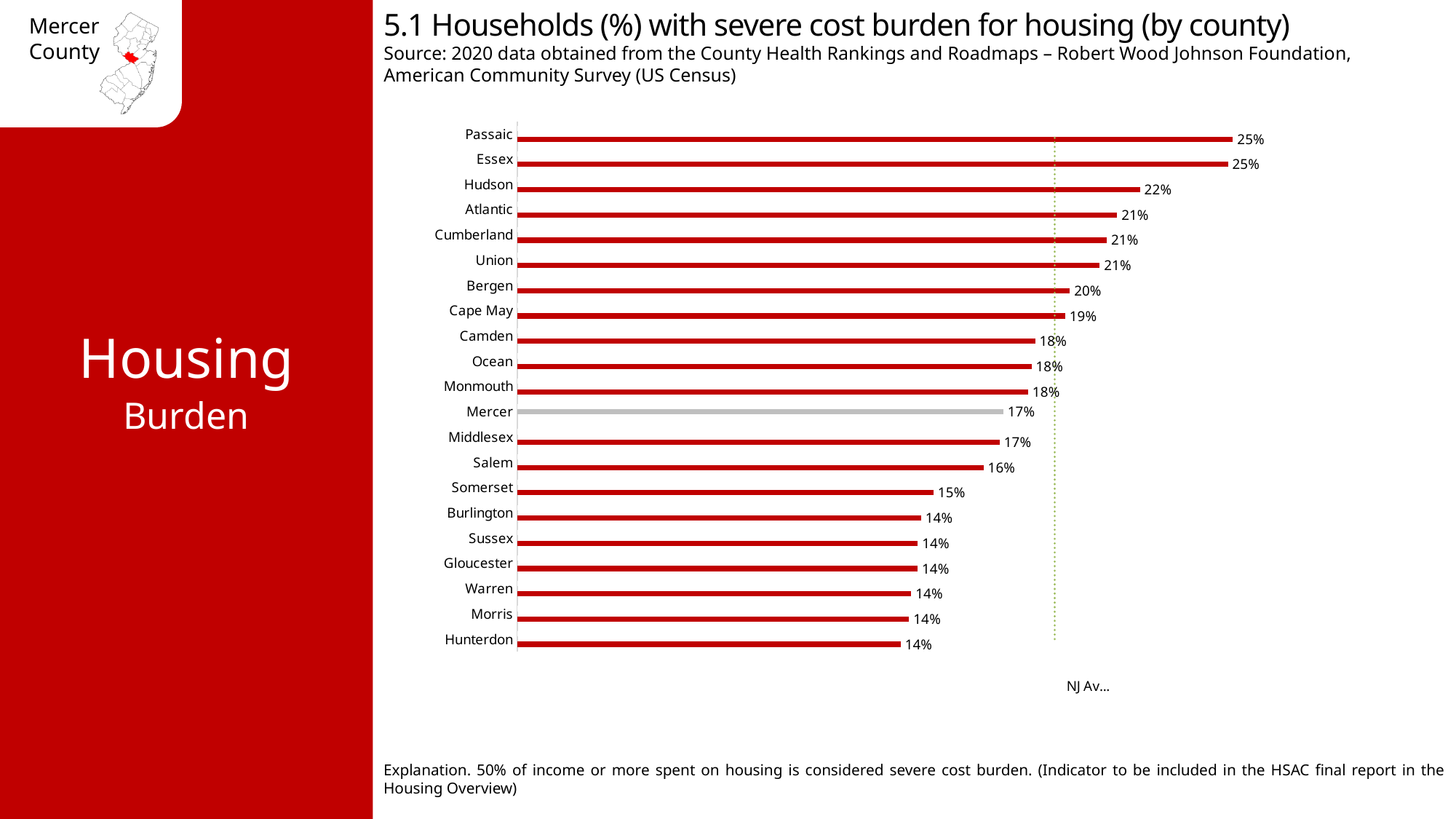
How many counties are shown in the chart? 21 What is the value for Cape May? 19% Which has a higher value, Bergen or Middlesex? Bergen What is the value for Hudson? 22% What is the difference between the values for Passaic and Hunterdon? 11 percentage points What is the difference between the values for Hudson and Mercer? 5 percentage points Which has a lower value, Atlantic or Somerset? Somerset What is the value for Somerset? 15% Which county's bar is drawn in grey instead of red? Mercer What kind of chart is shown on the slide? Bar chart What is the value for Mercer? 17% What is the value for Salem? 16%